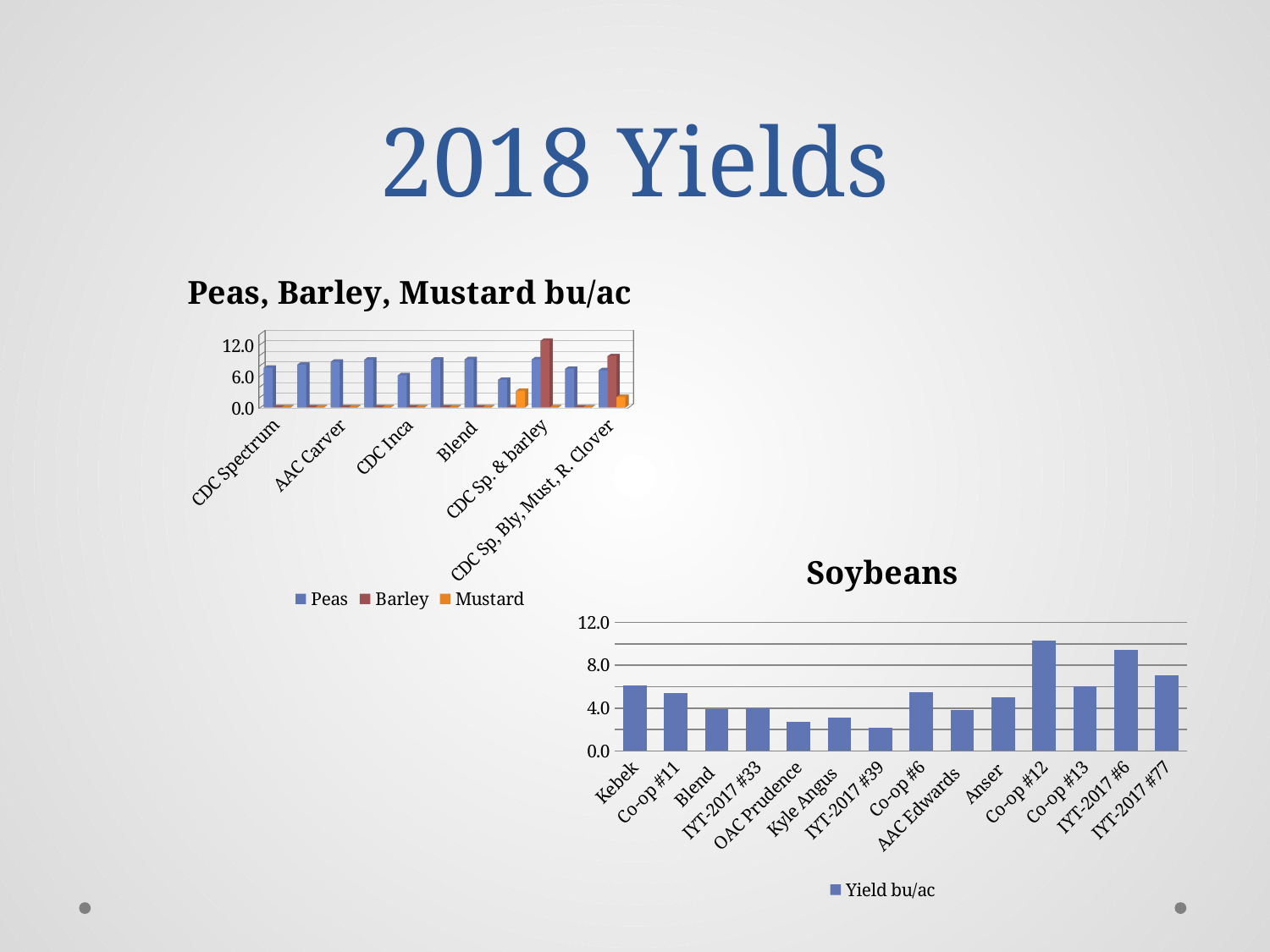
On the Soybeans chart, is the yield for IYT-2017 #39 greater or less than 4.0? less What kind of chart is the Soybeans chart? bar chart On the Soybeans chart, is the yield for Co-op #12 greater or less than 8.0? greater On the Soybeans chart, which variety has the highest yield? Co-op #12 On the Peas, Barley, Mustard bu/ac chart, is the Barley value for CDC Sp. & barley greater or less than 6.0? greater What series name does the legend of the Soybeans chart show? Yield bu/ac How many categories are shown on the Peas, Barley, Mustard bu/ac chart? 11 On the Peas, Barley, Mustard bu/ac chart, which category has the larger Barley value, CDC Sp. & barley or CDC Sp, Bly, Must, R. Clover? CDC Sp. & barley On the Soybeans chart, which variety has the lowest yield? IYT-2017 #39 On the Soybeans chart, which has the higher yield, Kebek or OAC Prudence? Kebek How many series does the legend of the Peas, Barley, Mustard bu/ac chart list? 3 How many varieties are shown on the Soybeans chart? 14